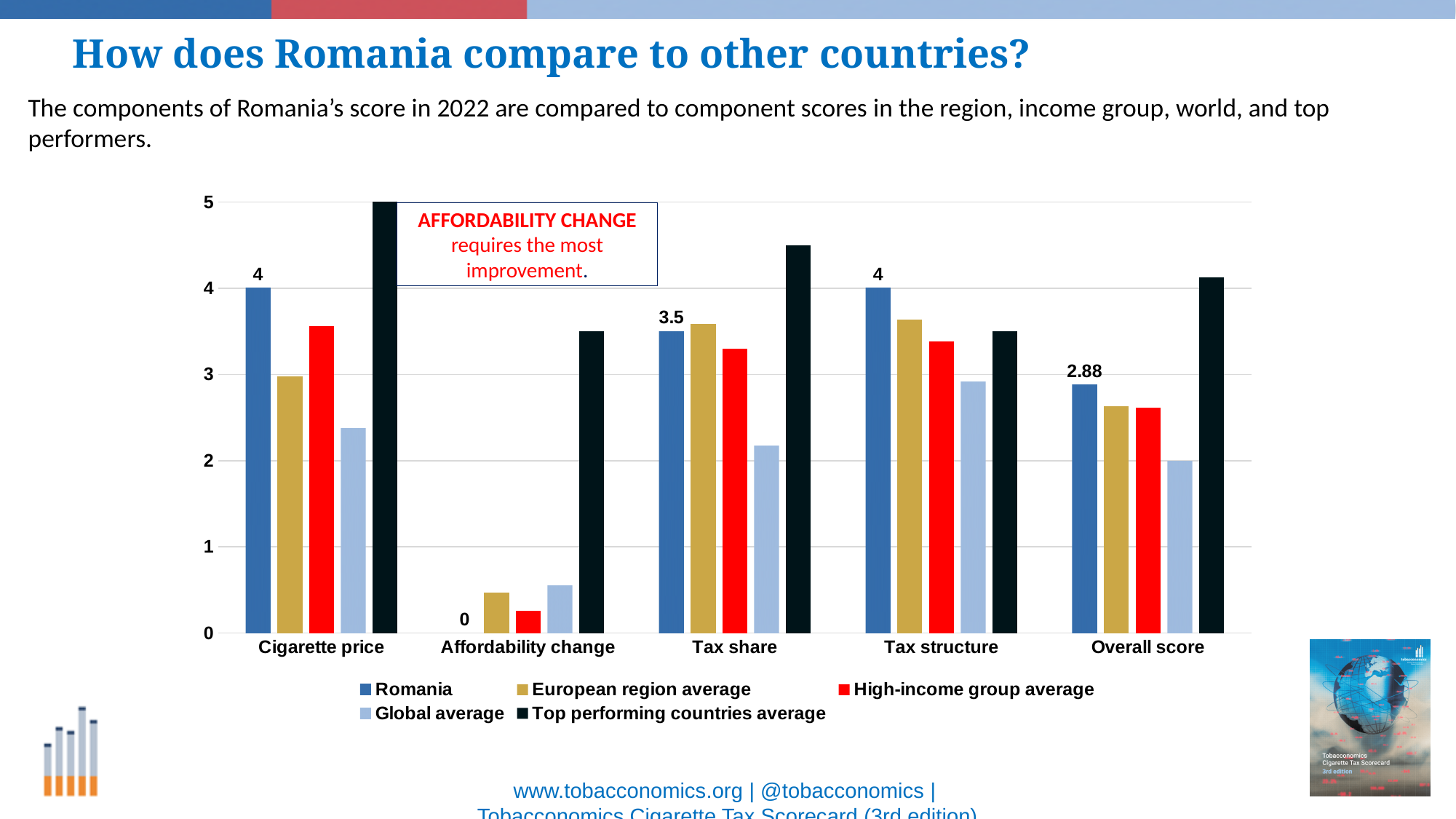
Which category has the lowest score for Romania? Affordability change For Romania, which is larger: the Tax share score or the Tax structure score? Tax structure How many categories are shown on the x axis? 5 What is Romania's score for Cigarette price? 4 How many series does the legend list? 5 What is the difference between Romania's Cigarette price score and its Overall score? 1.12 What is Romania's Overall score? 2.88 What kind of chart is shown on the slide? bar chart Is the Global average for Cigarette price greater or less than 3? less What is Romania's score for Tax share? 3.5 What is Romania's score for Affordability change? 0 Is the Top performing countries average for Tax share greater or less than 4? greater